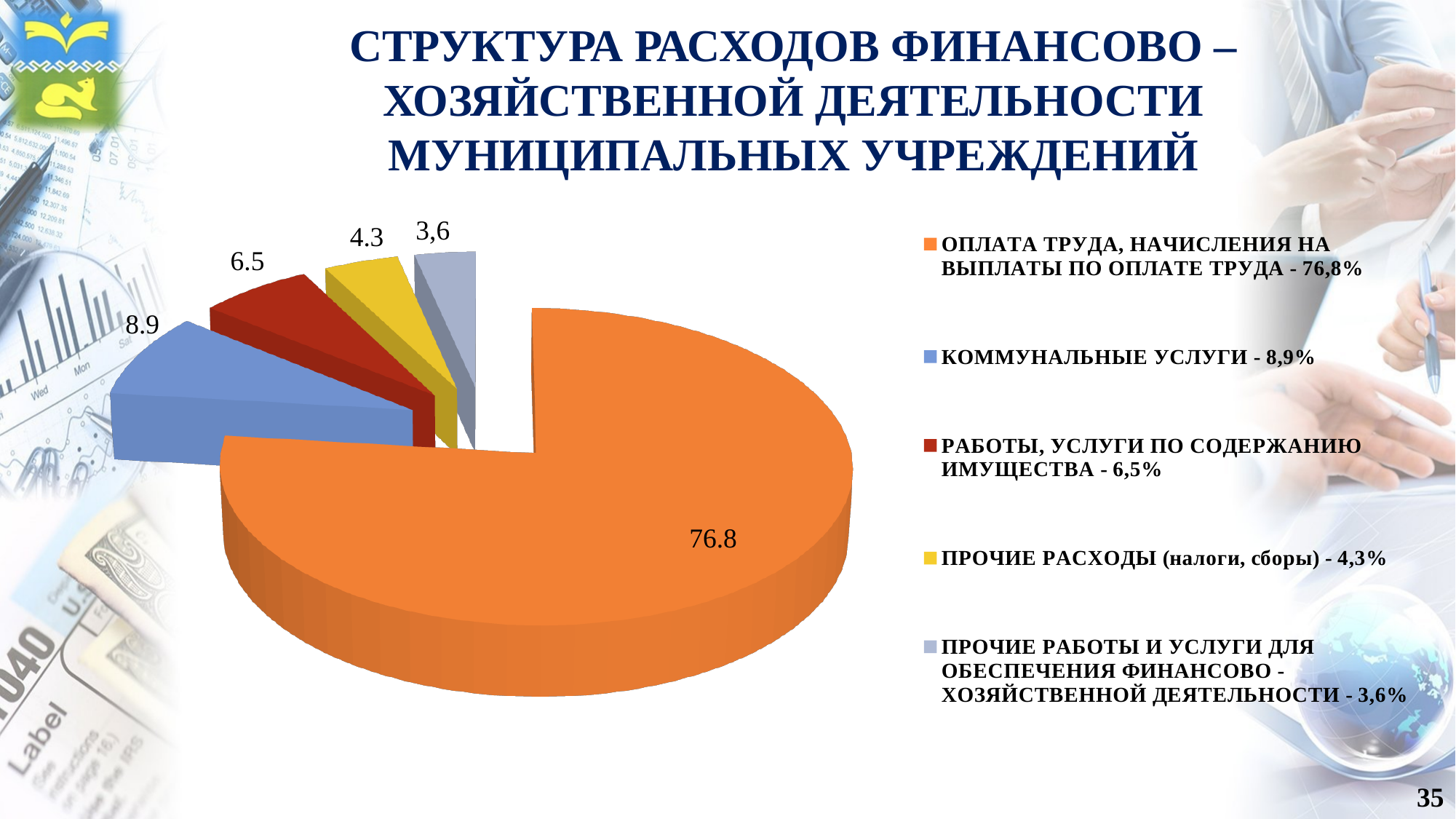
What value is shown for КОММУНАЛЬНЫЕ УСЛУГИ? 8.9 What is the difference between the values for ОПЛАТА ТРУДА, НАЧИСЛЕНИЯ НА ВЫПЛАТЫ ПО ОПЛАТЕ ТРУДА and КОММУНАЛЬНЫЕ УСЛУГИ? 67.9 What value is shown for ПРОЧИЕ РАБОТЫ И УСЛУГИ ДЛЯ ОБЕСПЕЧЕНИЯ ФИНАНСОВО-ХОЗЯЙСТВЕННОЙ ДЕЯТЕЛЬНОСТИ? 3,6 What colour is the largest slice of the pie chart? orange What value is shown for ОПЛАТА ТРУДА, НАЧИСЛЕНИЯ НА ВЫПЛАТЫ ПО ОПЛАТЕ ТРУДА? 76.8 What value is shown for РАБОТЫ, УСЛУГИ ПО СОДЕРЖАНИЮ ИМУЩЕСТВА? 6.5 What value is shown for ПРОЧИЕ РАСХОДЫ (налоги, сборы)? 4.3 Which is larger: КОММУНАЛЬНЫЕ УСЛУГИ or РАБОТЫ, УСЛУГИ ПО СОДЕРЖАНИЮ ИМУЩЕСТВА? КОММУНАЛЬНЫЕ УСЛУГИ Which category has the largest slice of the pie? ОПЛАТА ТРУДА, НАЧИСЛЕНИЯ НА ВЫПЛАТЫ ПО ОПЛАТЕ ТРУДА Which category has the smallest slice of the pie? ПРОЧИЕ РАБОТЫ И УСЛУГИ ДЛЯ ОБЕСПЕЧЕНИЯ ФИНАНСОВО-ХОЗЯЙСТВЕННОЙ ДЕЯТЕЛЬНОСТИ What kind of chart is shown on the slide? pie chart How many slices does the pie chart have? 5